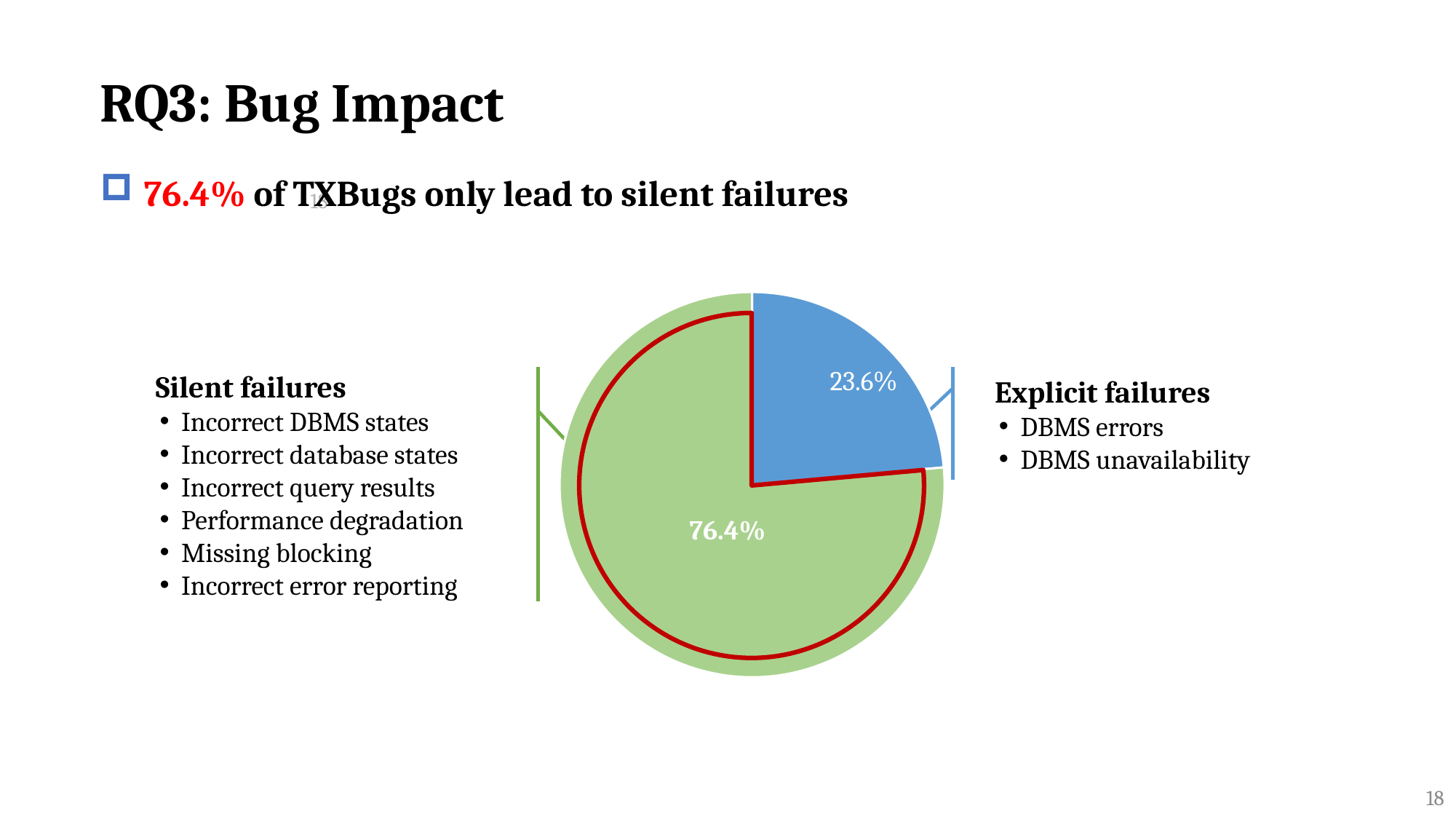
What kind of chart is shown on the slide? pie chart Which slice of the pie is the largest? Silent failures Which slice of the pie is the smallest? Explicit failures What colour is the slice representing explicit failures? blue What colour is the slice representing silent failures? green How many slices does the pie chart have? 2 What is the difference in percentage points between the silent failures slice and the explicit failures slice? 52.8 What share of the pie is labelled for silent failures? 76.4% What is the total of the two slice percentages shown on the pie chart? 100% What share of the pie is labelled for explicit failures? 23.6% Which is larger, the silent failures slice or the explicit failures slice? Silent failures